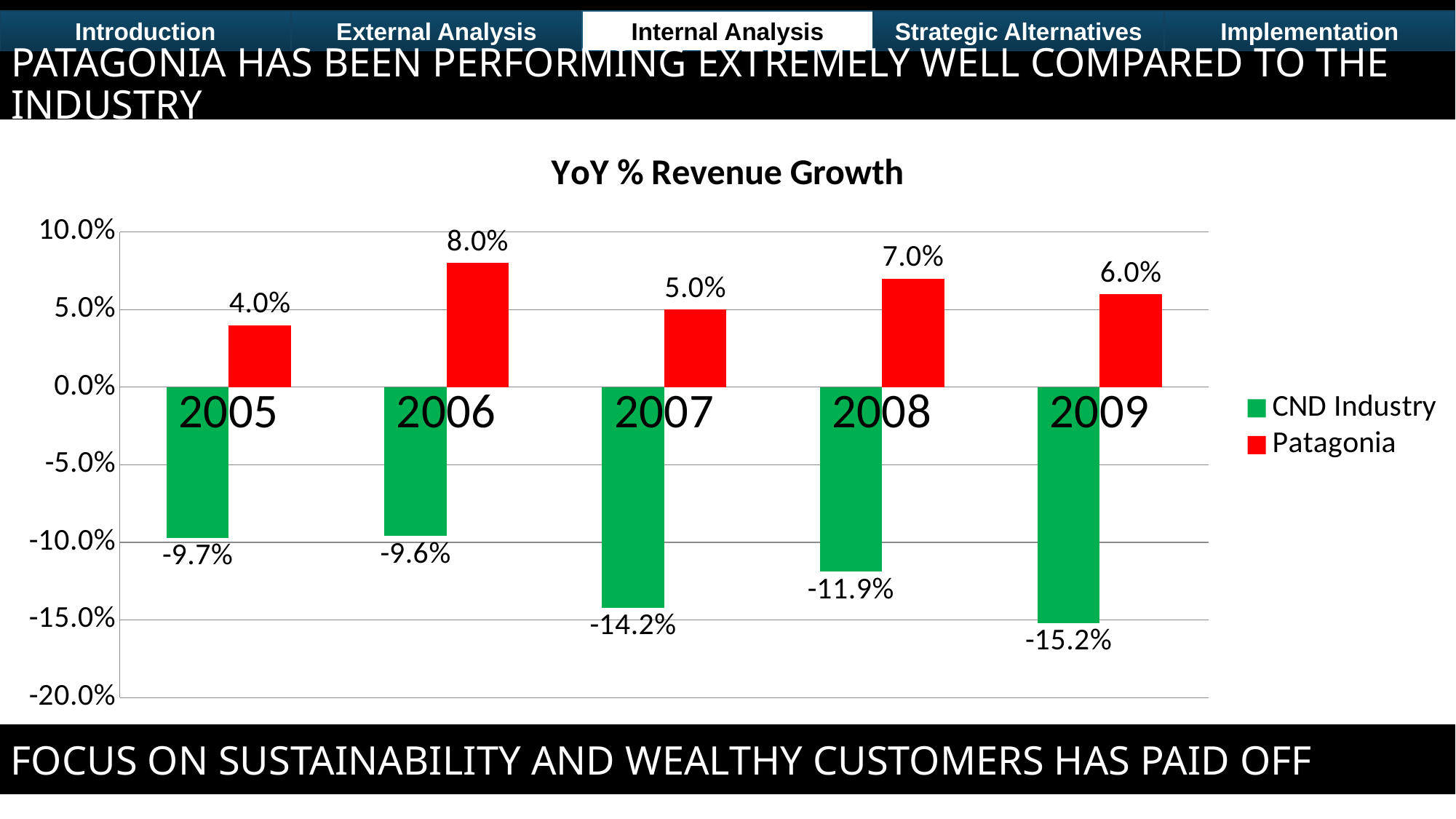
In which year did Patagonia have its highest YoY % revenue growth? 2006 In which year did the CND Industry have its lowest YoY % revenue growth? 2009 Which had higher YoY % revenue growth in 2005, Patagonia or the CND Industry? Patagonia What is the YoY % revenue growth for the CND Industry in 2007? -14.2% How many series does the chart legend list? 2 How many years are shown on the x axis of the chart? 5 What is the YoY % revenue growth for the CND Industry in 2009? -15.2% What type of chart is shown on the slide? Bar chart Is the CND Industry's YoY % revenue growth in 2008 greater or less than -10.0%? less What is the difference between Patagonia's and the CND Industry's YoY % revenue growth in 2008? 18.9% What is the YoY % revenue growth for Patagonia in 2006? 8.0% What is the title of the chart? YoY % Revenue Growth